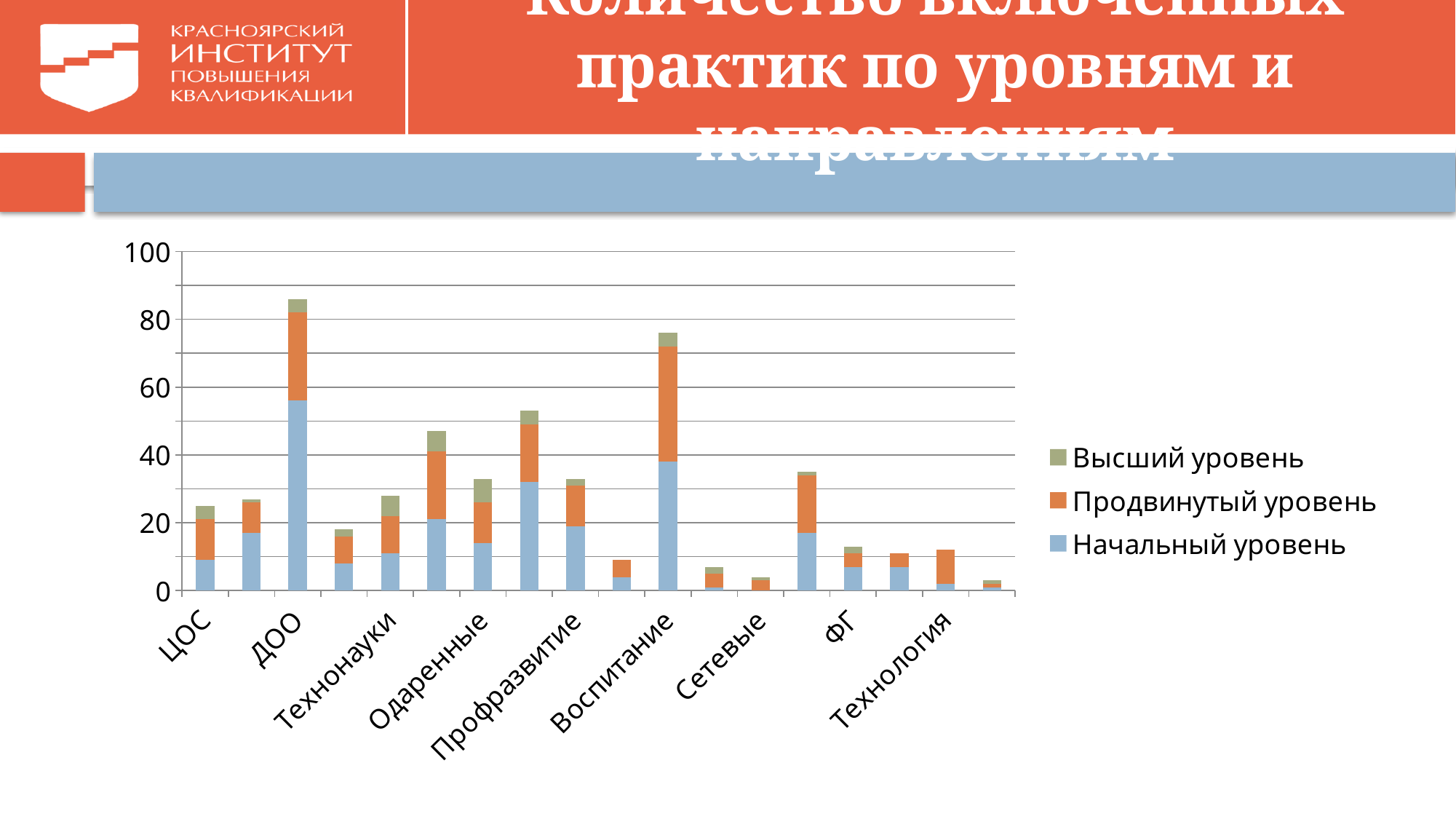
Is the total value of the bar for ФГ greater or less than 20? less Is the total value of the bar for ЦОС greater or less than 40? less Is the total value of the bar for ЦОС greater or less than 20? greater How many bars are plotted in the chart? 18 What kind of chart is shown on the slide? Stacked bar chart Which series is shown in blue in the legend? Начальный уровень Which has the taller bar, ЦОС or Одаренные? Одаренные How many series does the legend list? 3 Which series is shown in green in the legend? Высший уровень